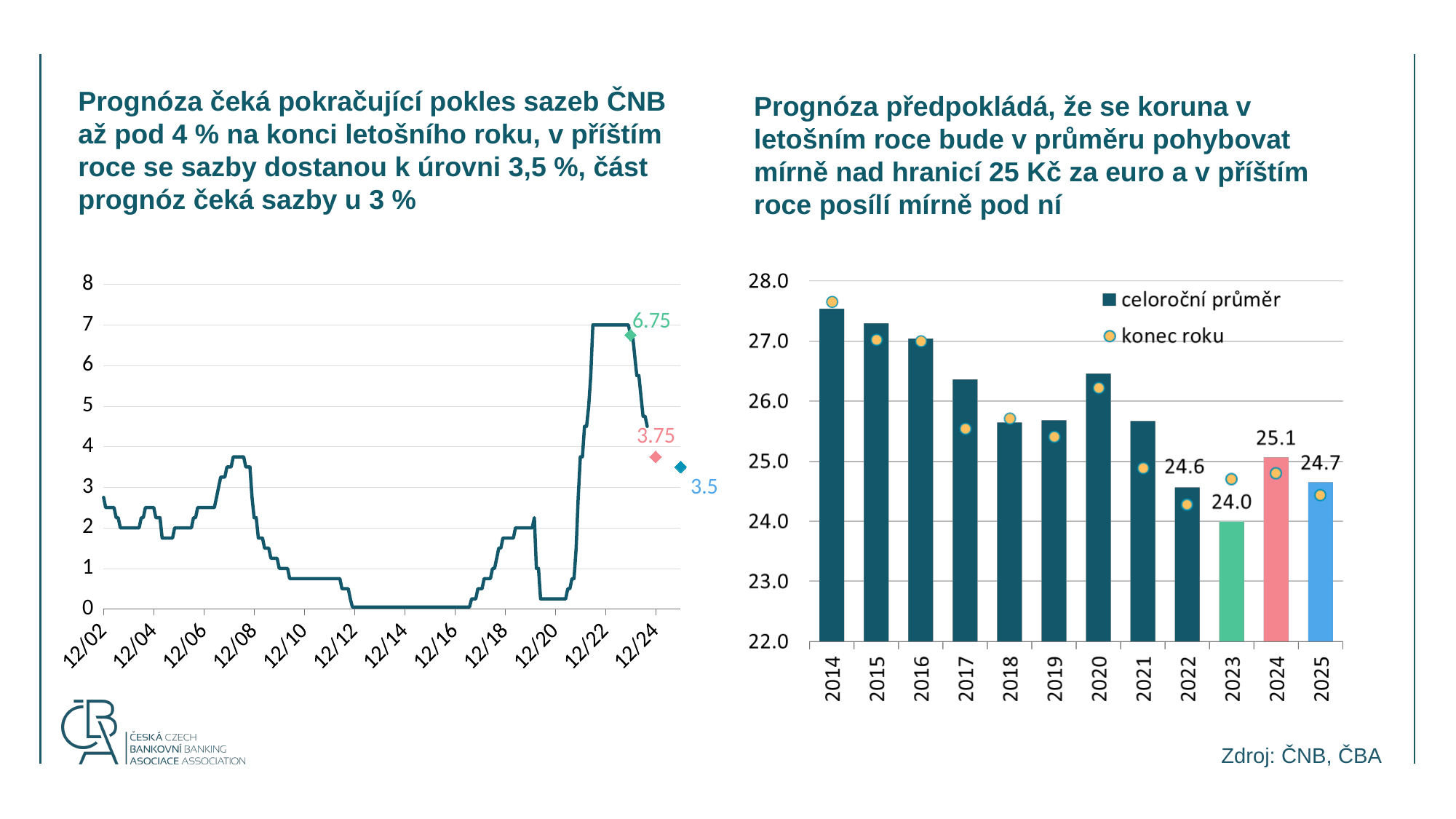
On the right chart, what is the celoroční průměr value for 2024? 25.1 On the right chart, how many years are shown on the x axis? 12 On the right chart, how many series does the legend list? 2 On the right chart, what is the celoroční průměr value for 2023? 24.0 On the left chart, what is the value of the blue labelled point at the far right? 3.5 On the right chart, what is the difference between the 2024 and 2023 celoroční průměr values? 1.1 On the left chart, is the value of the line at 12/22 greater or less than 6? greater On the left chart, what is the value of the red labelled point near 12/24? 3.75 On the right chart, which year has the highest celoroční průměr bar? 2014 On the left chart, what is the value of the green labelled point near 12/22? 6.75 On the left chart, is the value of the line at 12/14 greater or less than 1? less What kind of chart is the left chart showing CNB rates? line chart